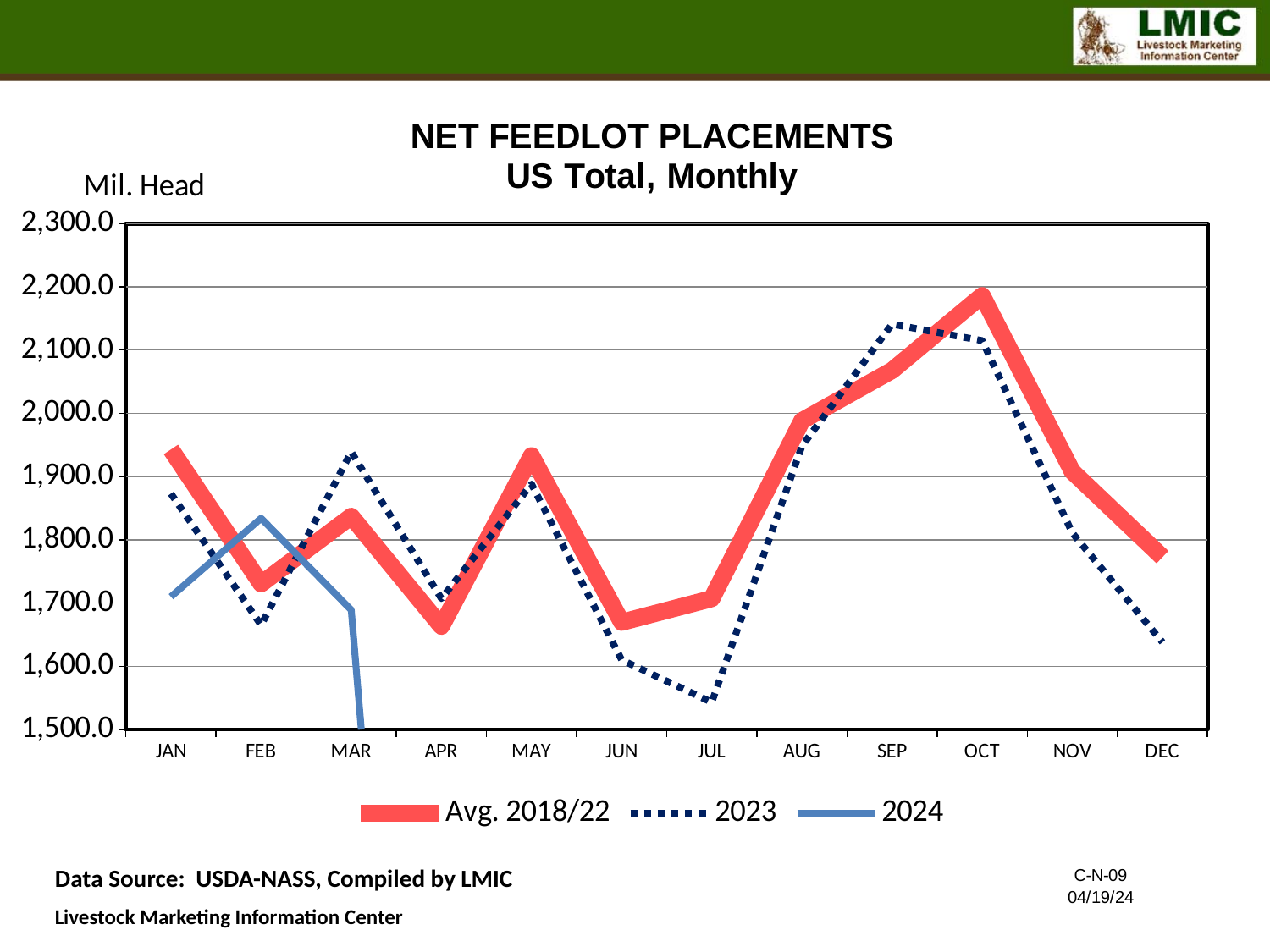
What unit label is shown above the y axis? Mil. Head In which month does the Avg. 2018/22 series reach its highest value? OCT In which month does the Avg. 2018/22 series reach its lowest value? APR What kind of chart is shown on the slide? line chart In MAR, which series has the larger value, Avg. 2018/22 or 2023? 2023 In which month does the 2023 series reach its lowest value? JUL Does the Avg. 2018/22 series rise or fall from OCT to DEC? fall Is the value for the 2024 series in FEB greater or less than 1,800.0? greater How many months are shown on the x axis? 12 How many series does the legend list? 3 Is the value for the Avg. 2018/22 series in JAN greater or less than 1,900.0? greater Is the value for the 2023 series in JUL greater or less than 1,600.0? less